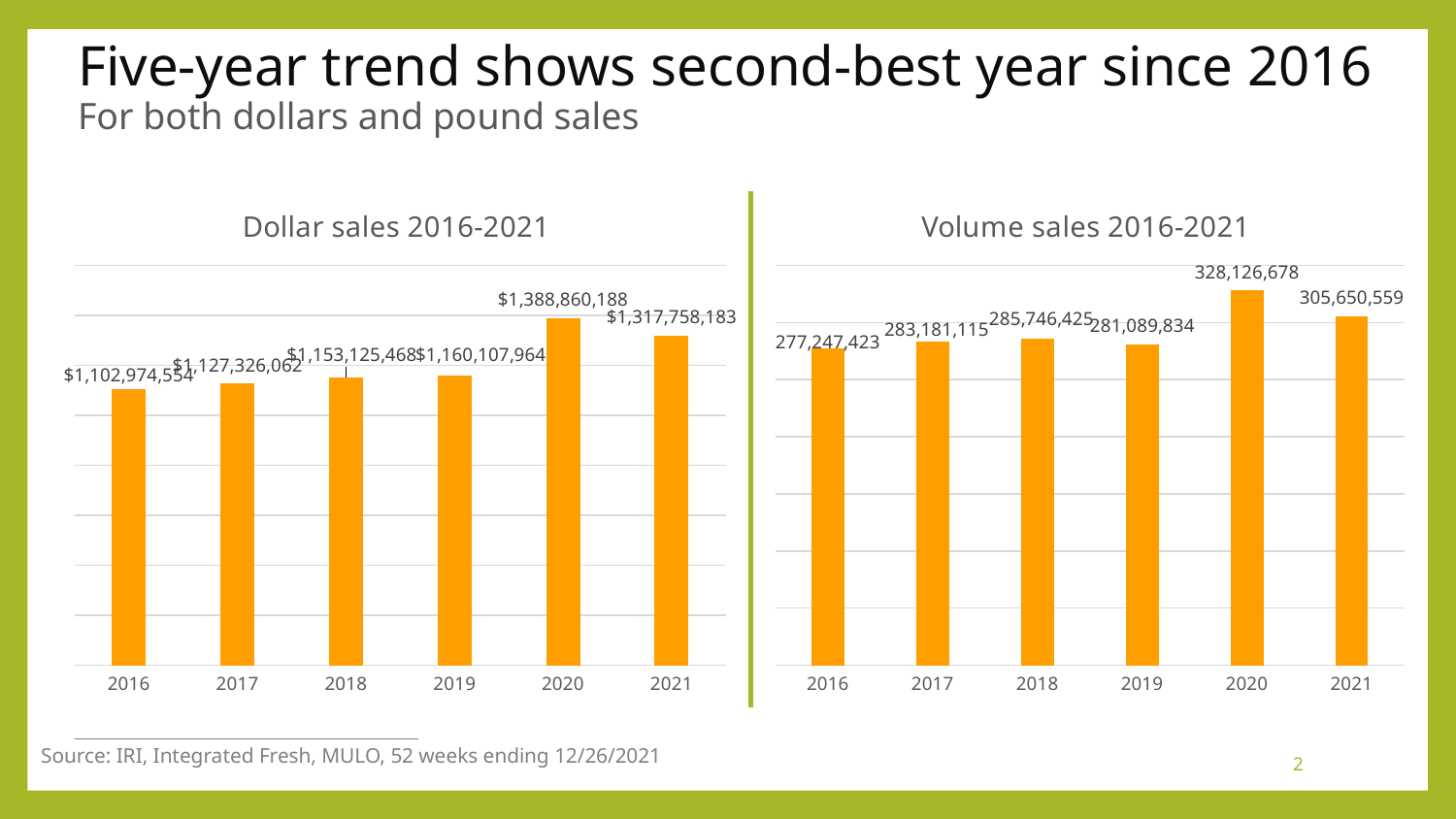
In the Volume sales 2016-2021 chart, which is larger, the value for 2018 or the value for 2019? 2018 In the Dollar sales 2016-2021 chart, what is the value for 2021? $1,317,758,183 In the Dollar sales 2016-2021 chart, what is the value for 2020? $1,388,860,188 In the Dollar sales 2016-2021 chart, what is the value for 2019? $1,160,107,964 In the Dollar sales 2016-2021 chart, what is the difference between the 2020 and 2021 values? $71,102,005 In the Volume sales 2016-2021 chart, which year has the lowest volume sales? 2016 What kind of chart is the Volume sales 2016-2021 chart? Bar chart How many years are shown on the x axis of the Dollar sales 2016-2021 chart? 6 In the Dollar sales 2016-2021 chart, which year has the highest dollar sales? 2020 In the Volume sales 2016-2021 chart, what is the difference between the 2020 and 2021 values? 22,476,119 In the Volume sales 2016-2021 chart, what is the value for 2021? 305,650,559 In the Volume sales 2016-2021 chart, what is the value for 2020? 328,126,678